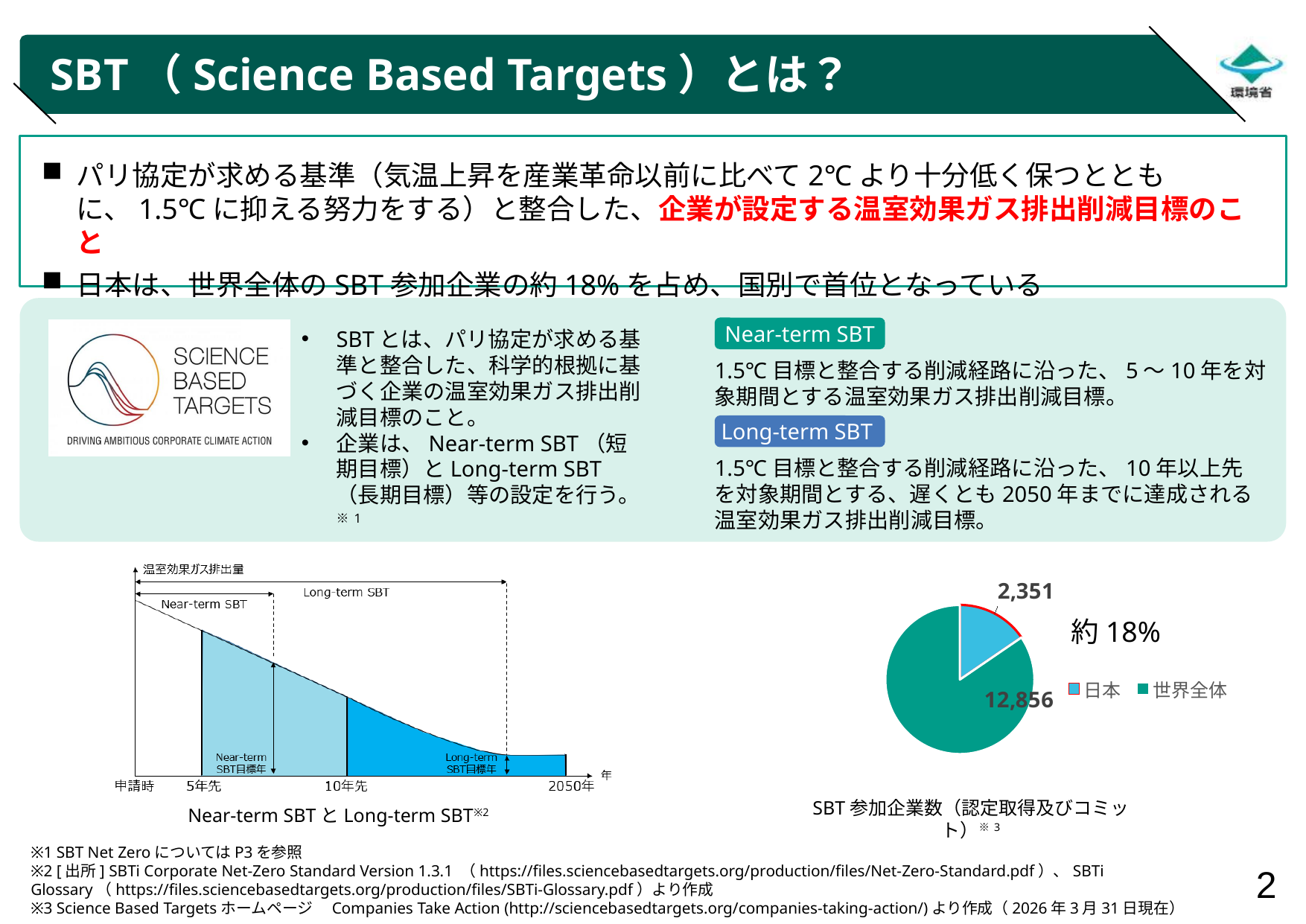
What are the two legend entries of the pie chart on the right? 日本, 世界全体 In the pie chart on the right, what is the difference between the value for 世界全体 and the value for 日本? 10,505 What kind of chart is the chart titled 'SBT参加企業数（認定取得及びコミット）' on the right of the slide? pie chart In the pie chart on the right, what is the value for 日本? 2,351 In the pie chart on the right, which category has the larger value, 日本 or 世界全体? 世界全体 What percentage is printed next to the pie chart on the right to indicate Japan's share? 約 18% In the pie chart on the right, what is the value for 世界全体? 12,856 How many entries does the legend of the pie chart on the right list? 2 In the pie chart on the right, which category has the largest slice? 世界全体 In the pie chart on the right, which category has the smallest slice? 日本 How many slices does the pie chart on the right have? 2 What is the caption under the pie chart on the right? SBT 参加企業数（認定取得及びコミット）